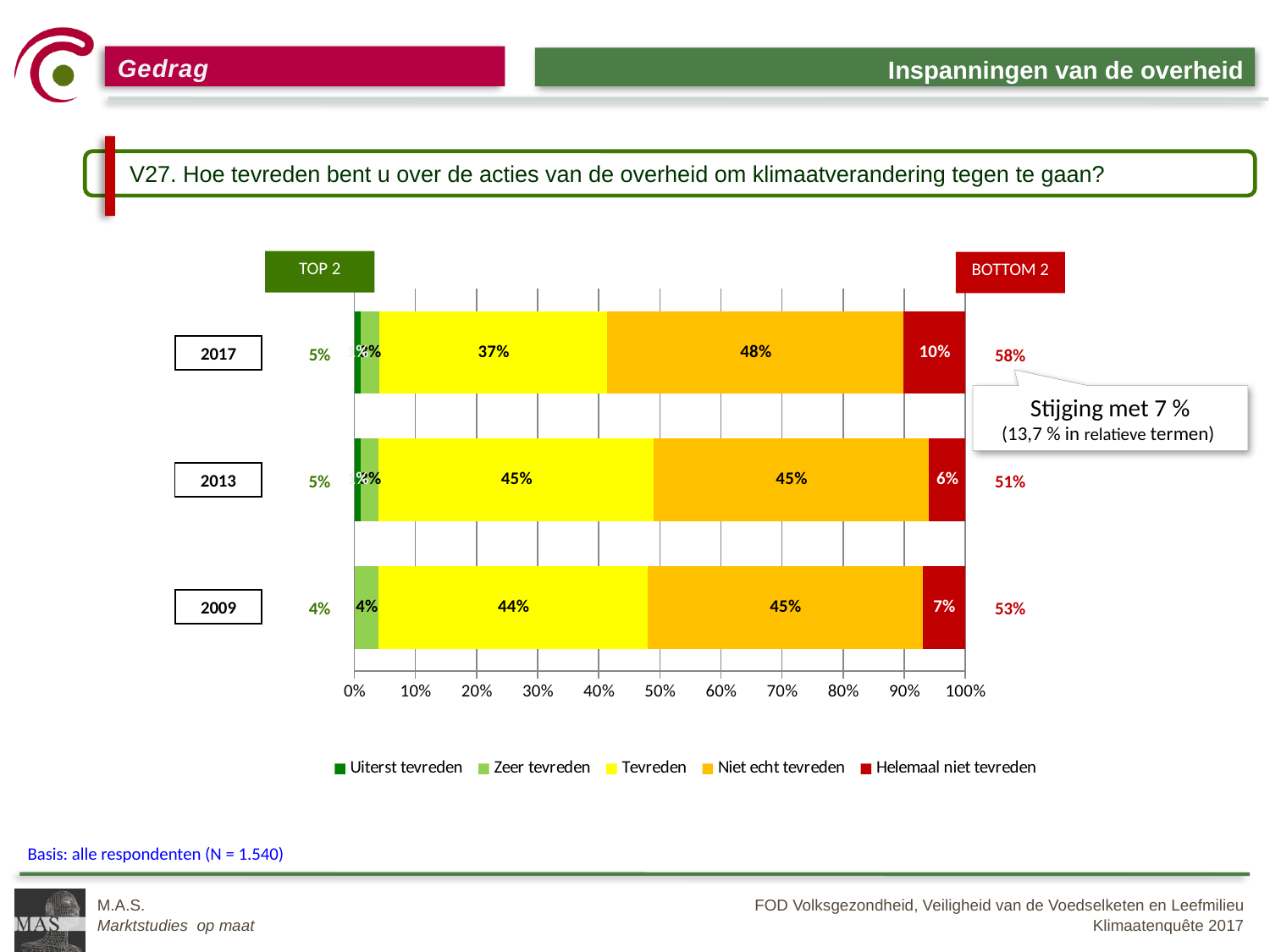
How many series does the legend list? 5 What is the value for 'Tevreden' in 2017? 37% What is the value for 'Niet echt tevreden' in 2017? 48% What is the difference between the 'Tevreden' values for 2013 and 2017? 8% What is the value for 'Helemaal niet tevreden' in 2013? 6% Which year has the lowest 'Tevreden' value? 2017 How many years (categories) are plotted in the chart? 3 What is the value for 'Zeer tevreden' in 2009? 4% What kind of chart is shown on the slide? stacked bar chart Which year has the highest 'Helemaal niet tevreden' value? 2017 Is the 'Tevreden' value for 2009 larger or smaller than the 'Niet echt tevreden' value for 2009? smaller What is the BOTTOM 2 value for 2017? 58%